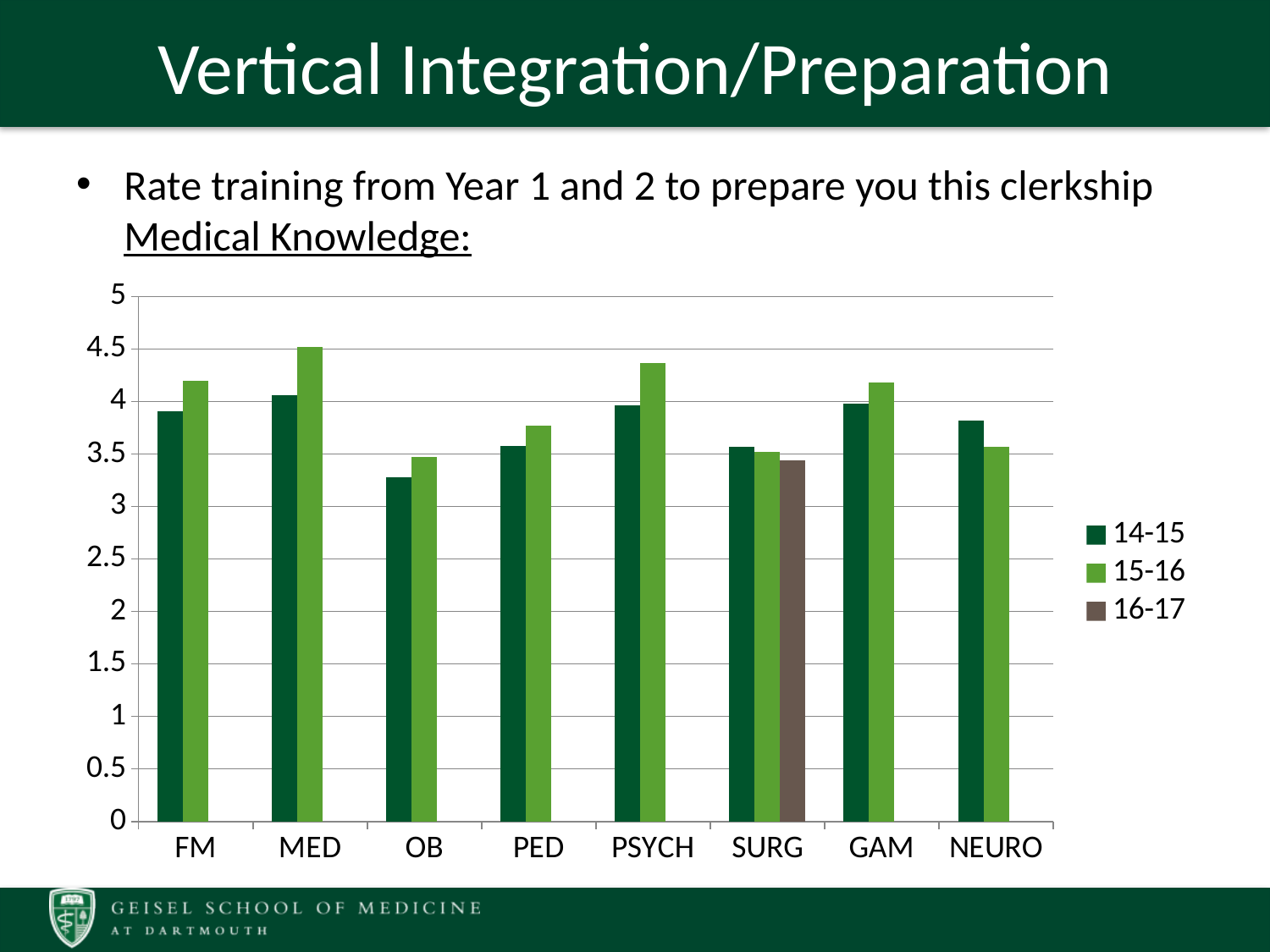
Is the 15-16 value for NEURO greater or less than 4? less What kind of chart is shown on the slide? bar chart For FM, which series has the larger value, 14-15 or 15-16? 15-16 Is the 14-15 value for OB greater or less than 3.5? less How many series does the chart's legend list? 3 Which category has the highest value for the 15-16 series? MED Which category has the lowest value for the 14-15 series? OB How many clerkship categories are shown on the x axis of the chart? 8 Is the 16-17 value for SURG greater or less than 3.5? less For NEURO, which series has the larger value, 14-15 or 15-16? 14-15 Which category is the only one with a bar for the 16-17 series? SURG